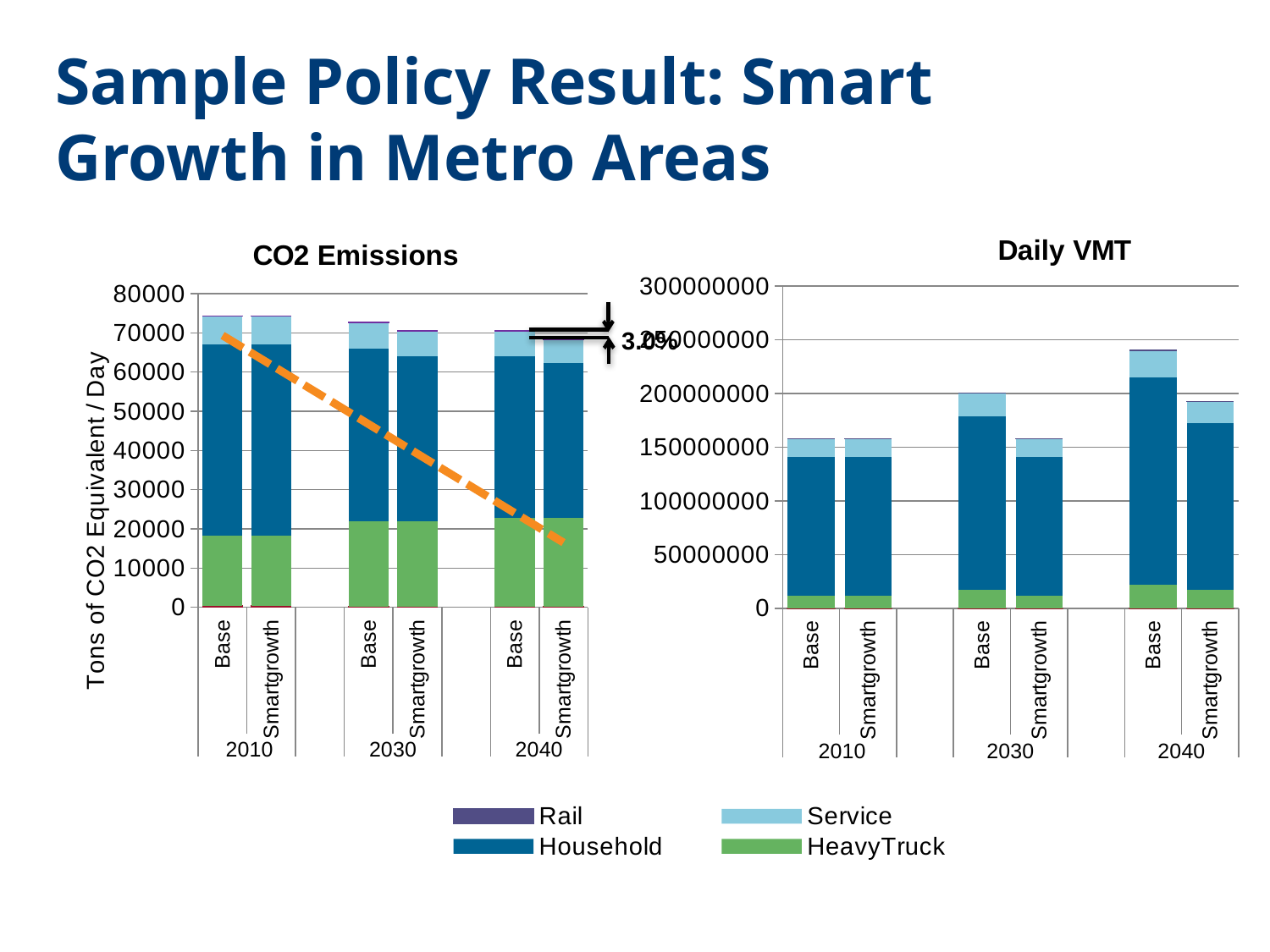
How many bars are plotted in the Daily VMT chart? 6 In the Daily VMT chart, which is larger for 2040: Base or Smartgrowth? Base What is the y-axis label of the CO2 Emissions chart? Tons of CO2 Equivalent / Day In the Daily VMT chart, do the Base totals rise or fall from 2010 to 2040? rise In the CO2 Emissions chart, is the total for 2010 Base greater or less than 70000? greater In the CO2 Emissions chart, is the total for 2040 Smartgrowth greater or less than 70000? less In the Daily VMT chart, is the total for 2030 Smartgrowth greater or less than 200000000? less In the CO2 Emissions chart, which is larger: 2010 Base or 2040 Smartgrowth? 2010 Base What kind of chart is the CO2 Emissions chart? Combination stacked bar and line chart How many series does the shared legend list? 4 In the Daily VMT chart, which bar has the highest total? 2040 Base